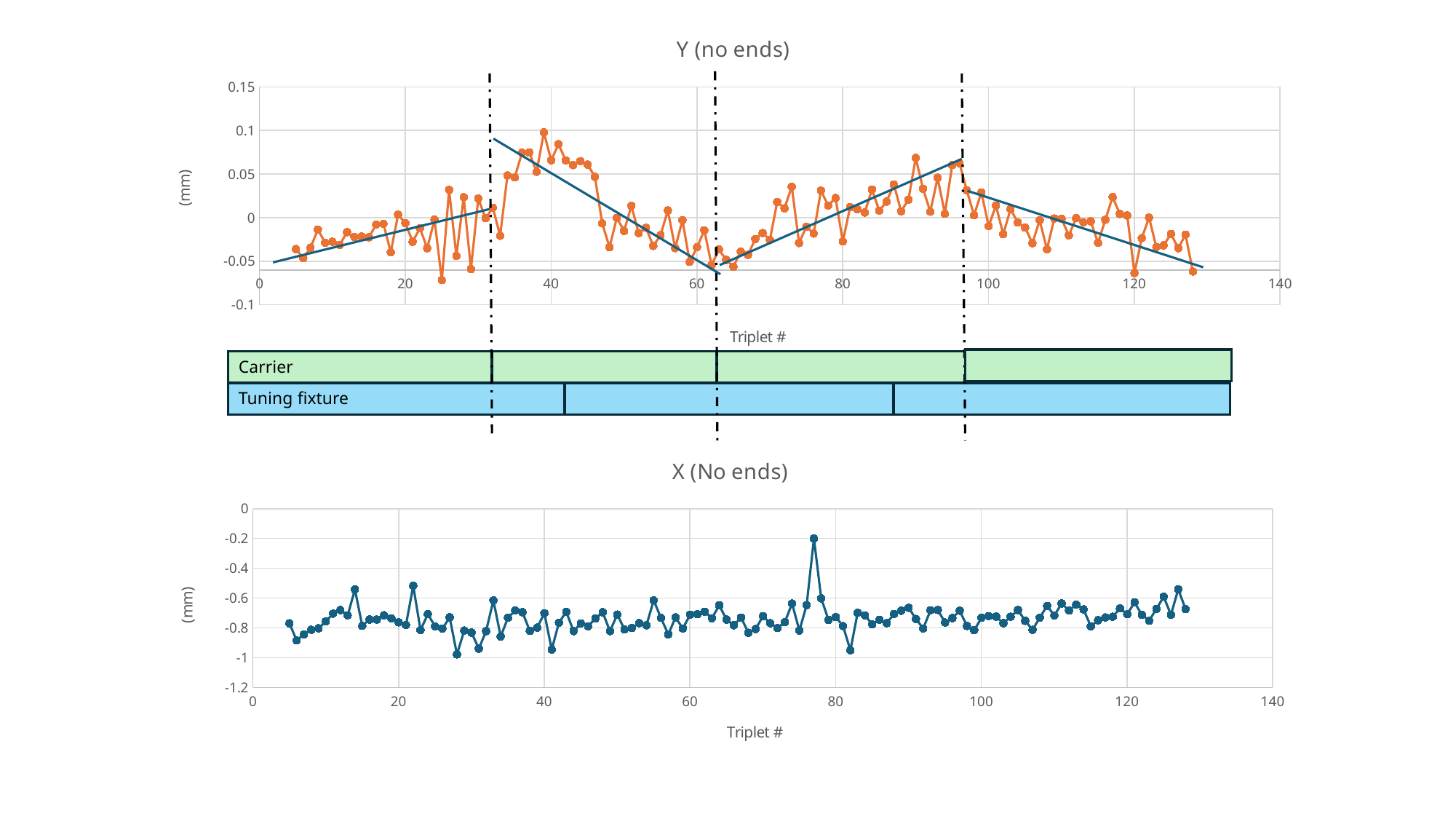
What kind of chart is the "Y (no ends)" chart? Line chart In the "X (No ends)" chart, is the lowest point greater or less than -0.8? less In the "Y (no ends)" chart, do the values rise or fall between triplet 65 and triplet 95? rise What unit is shown on the y-axis of the "Y (no ends)" chart? (mm) What kind of chart is the "X (No ends)" chart? Line chart In the "X (No ends)" chart, is the highest point greater or less than -0.4? greater In the "Y (no ends)" chart, is the highest point greater or less than 0.05? greater How many charts are shown on the slide? 2 In the "Y (no ends)" chart, do the values rise or fall between triplet 40 and triplet 60? fall What is the x-axis label of the "X (No ends)" chart? Triplet #